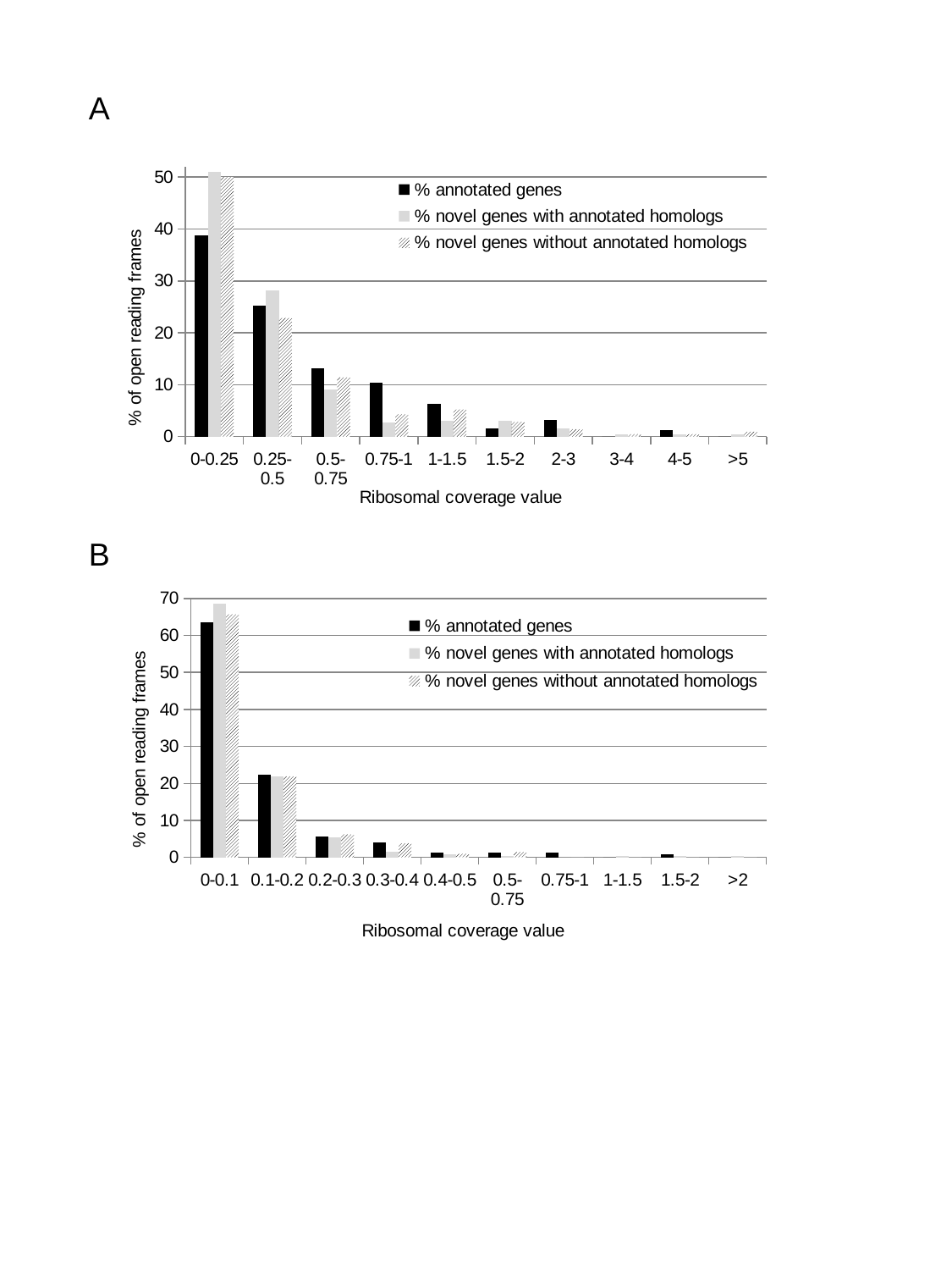
In chart B (bottom), at 0-0.1, which is larger: % annotated genes or % novel genes with annotated homologs? % novel genes with annotated homologs In chart A (top), is the value for % novel genes with annotated homologs at 0-0.25 greater or less than 40? greater In chart A (top), how many ribosomal coverage value categories are shown on the x axis? 10 What kind of chart is chart B (bottom)? Bar chart In chart B (bottom), which category has the highest value for % novel genes with annotated homologs? 0-0.1 In chart A (top), how many series does the legend list? 3 What is the x-axis title of chart A (top)? Ribosomal coverage value In chart A (top), is the value for % annotated genes at 0-0.25 greater or less than 40? less In chart B (bottom), do the values for % annotated genes generally rise or fall along the x axis? fall In chart B (bottom), is the value for % annotated genes at 0-0.1 greater or less than 60? greater In chart A (top), at 0.5-0.75, which is larger: % annotated genes or % novel genes with annotated homologs? % annotated genes In chart A (top), which category has the highest value for % annotated genes? 0-0.25